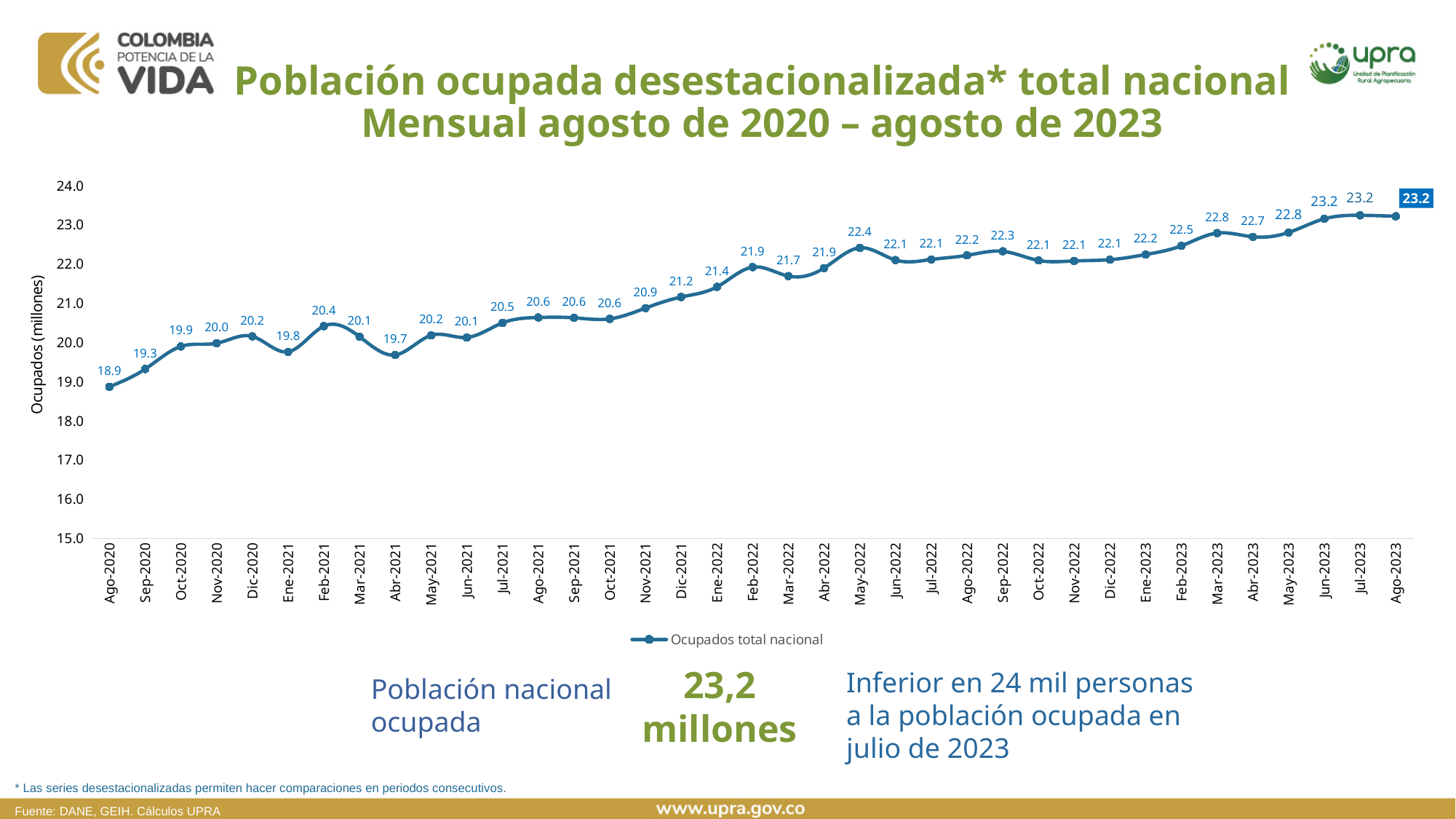
What is the value for Abr-2021? 19.7 What is the value for Ago-2020? 18.9 Which is larger, the value for Feb-2022 or the value for Mar-2022? Feb-2022 What is the label of the y axis? Ocupados (millones) What is the difference between the values for Ago-2023 and Ago-2020? 4.3 What kind of chart is shown? Line chart Which month has the lowest value? Ago-2020 What is the value for May-2022? 22.4 Is the value for Dic-2021 greater or less than 21.0? greater What is the value for Ago-2023? 23.2 How many series does the legend list? 1 How many monthly data points are plotted? 37